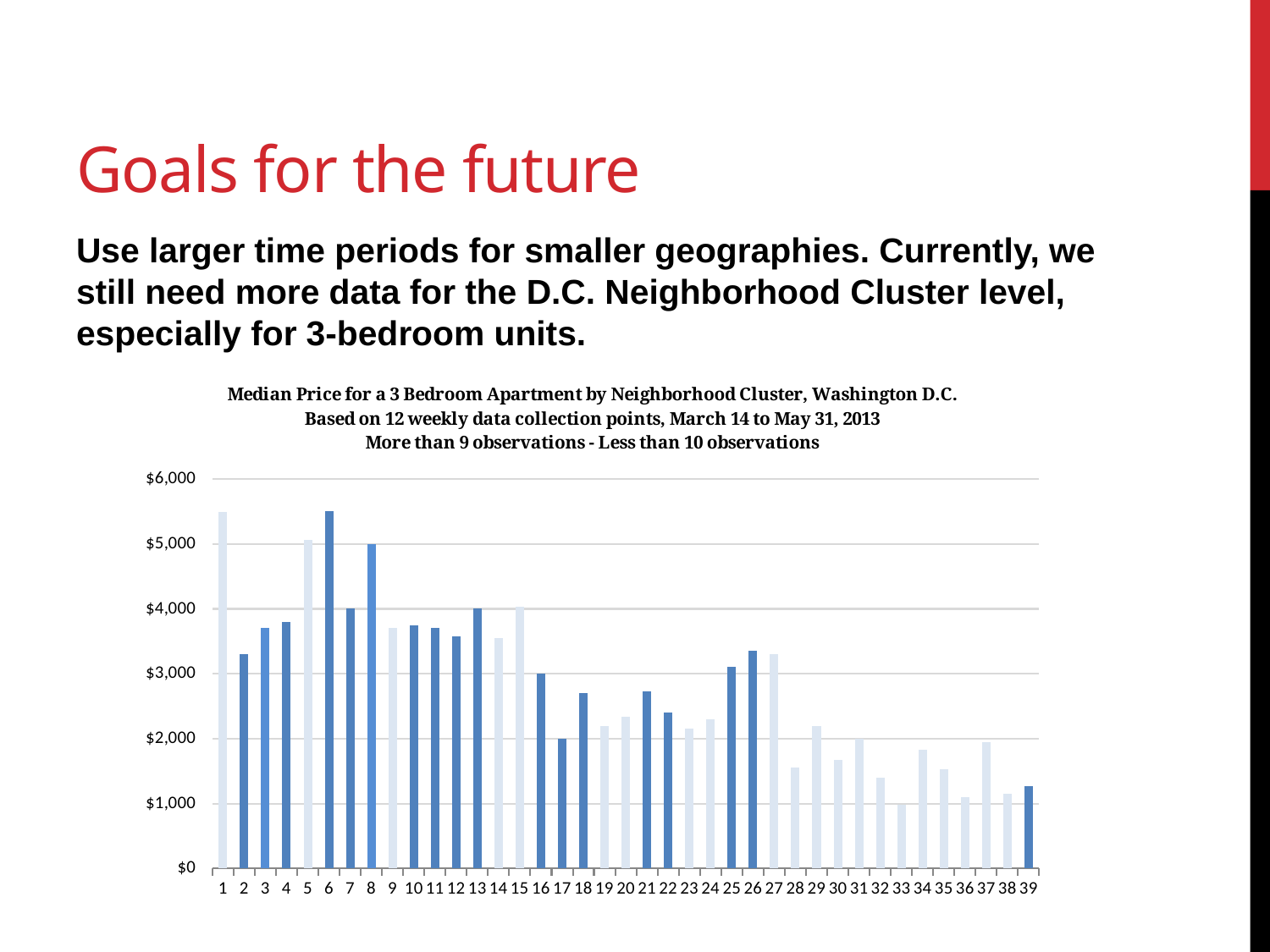
Is the median price for cluster 8 greater or less than $4,000? greater How many neighborhood clusters are plotted along the x axis? 39 Is the median price for cluster 6 greater or less than $5,000? greater Which has a higher median price, cluster 33 or cluster 25? cluster 25 According to the chart title, how many weekly data collection points is the chart based on? 12 Do the median prices generally rise or fall as the cluster number increases from 1 to 39? fall What is the highest value shown on the y axis? $6,000 What kind of chart is shown on the slide? bar chart Is the median price for cluster 2 greater or less than $3,000? greater Which has a higher median price, cluster 8 or cluster 17? cluster 8